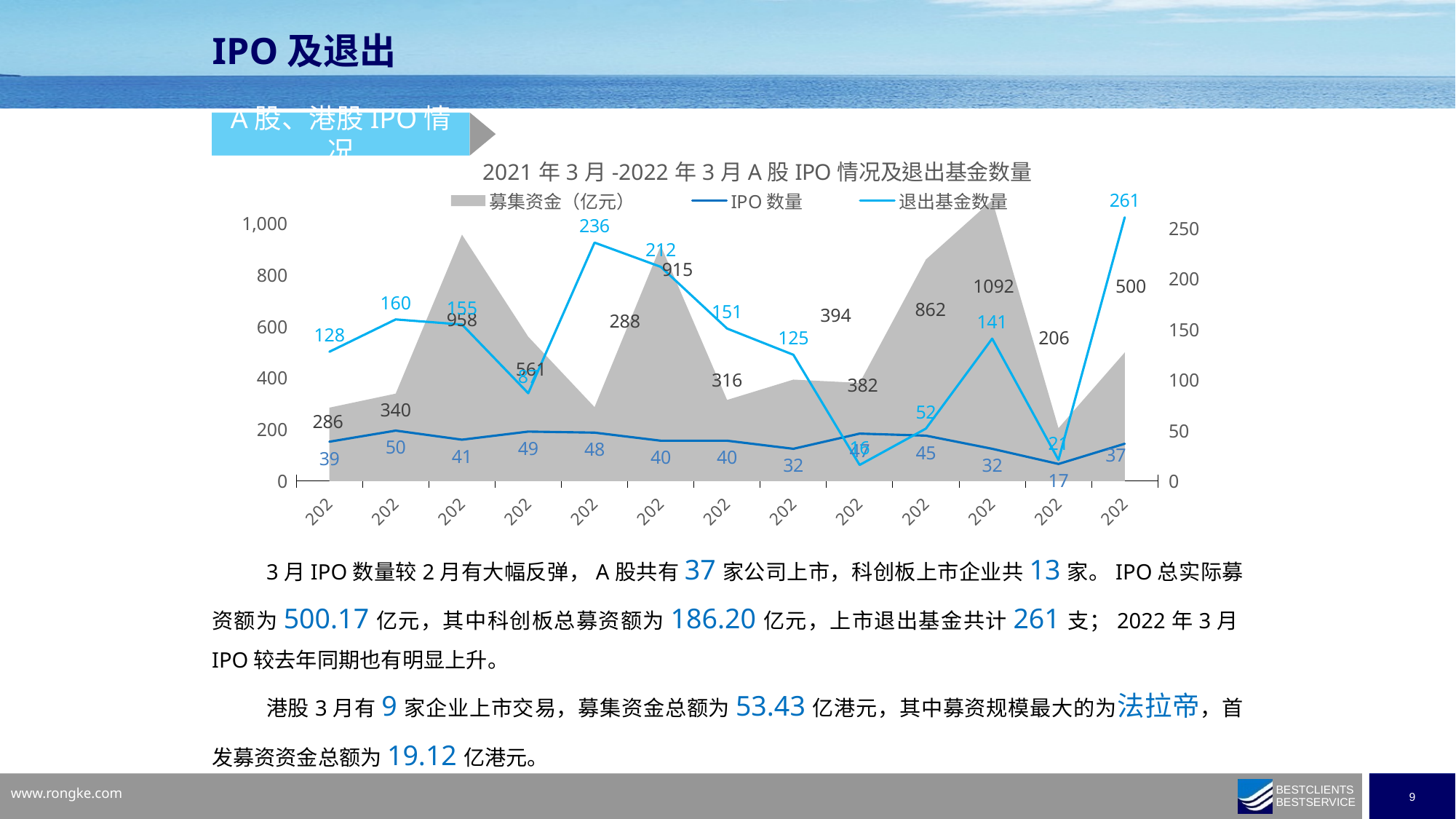
What kind of chart is this? Combined area and line chart How many series does the chart legend list? 3 What is the highest value of 退出基金数量 shown in the chart? 261 What is the title of the chart? 2021年3月-2022年3月A股IPO情况及退出基金数量 What is the lowest value of 募集资金（亿元） shown in the chart? 206 How many data points does each series in the chart have? 13 What is the lowest value of IPO 数量 shown in the chart? 17 What is the difference between the highest 募集资金（亿元） value (1092) and the lowest (206)? 886 What is the value of 募集资金（亿元） at the last data point (2022年3月)? 500 What is the highest value of 募集资金（亿元） shown in the chart? 1092 Which is larger: the 退出基金数量 at the first data point (128) or at the last data point (261)? 261 (last data point) What is the highest value of IPO 数量 shown in the chart? 50